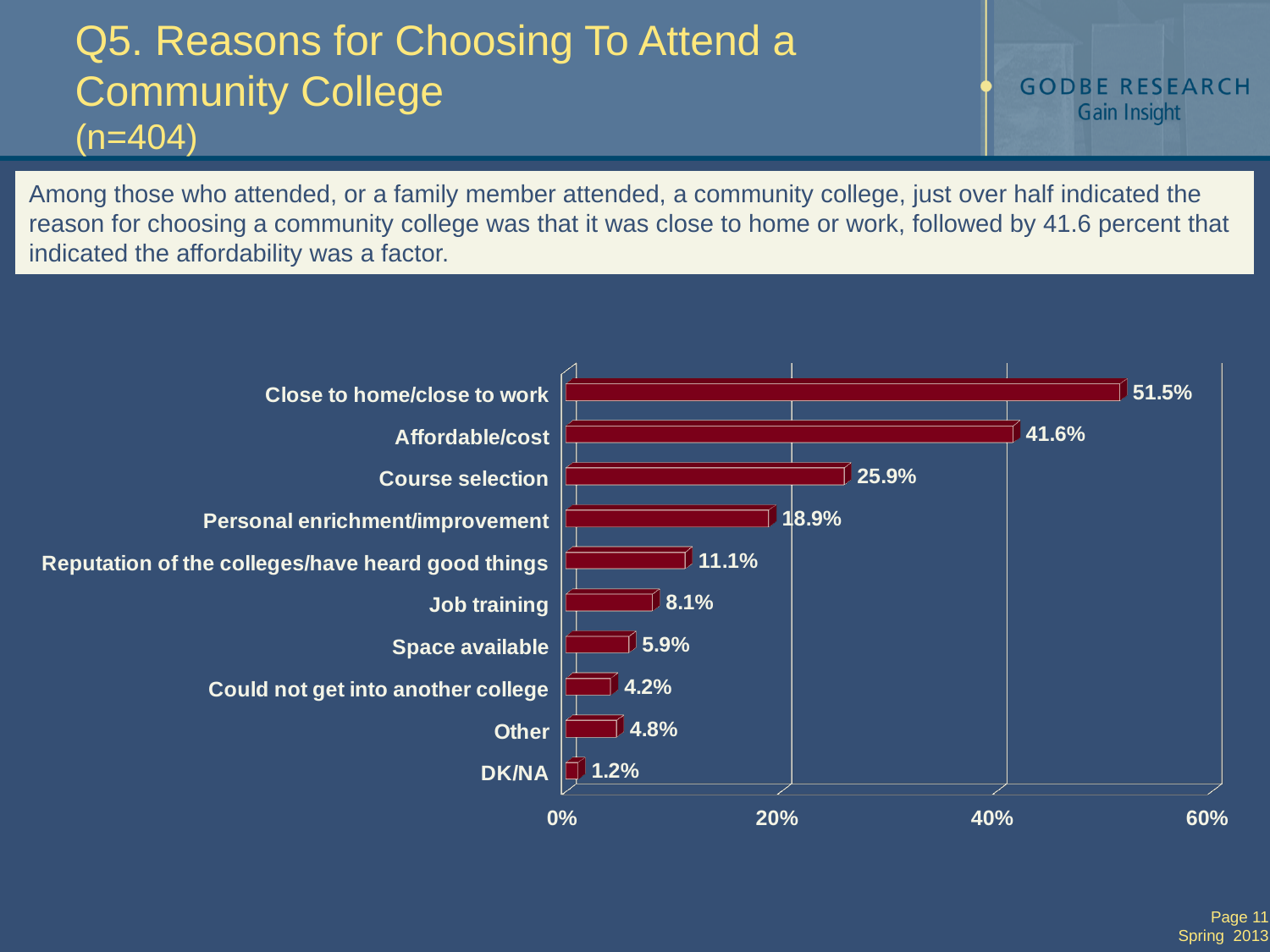
Which category has the lowest percentage? DK/NA Is the value for Personal enrichment/improvement greater or less than 20%? less What percentage is shown for Job training? 8.1% Which is larger, Other or Could not get into another college? Other How many reason categories are shown in the chart? 10 What percentage of respondents chose a community college because it was close to home/close to work? 51.5% What is the value for DK/NA? 1.2% Which reason has the highest percentage? Close to home/close to work What is the highest value shown on the horizontal axis? 60% What kind of chart is shown on the slide? Bar chart What is the value shown for Course selection? 25.9% What is the difference between Close to home/close to work and Affordable/cost? 9.9%